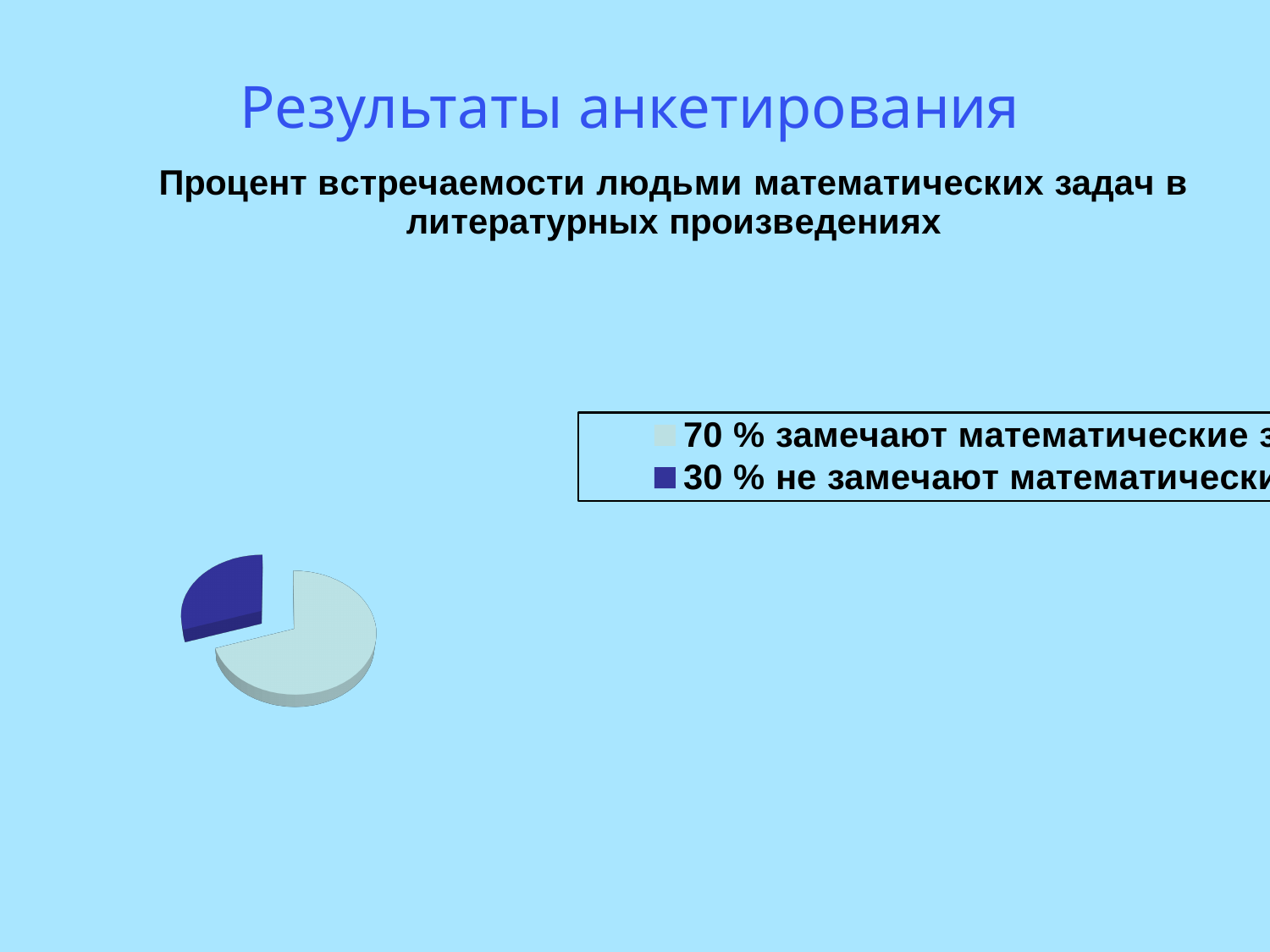
How many entries does the legend of the pie chart list? 2 According to the legend, what percentage of people notice mathematical problems (замечают математические задачи)? 70 % According to the legend, what percentage of people do not notice mathematical problems (не замечают математические задачи)? 30 % What kind of chart is shown on the slide? pie chart What colour is the slice representing the 30 % who do not notice mathematical problems? dark blue What is the title of the chart on the slide? Процент встречаемости людьми математических задач в литературных произведениях What is the difference in percentage points between the share of people who notice mathematical problems and those who do not? 40 Which category has the smallest share of the pie? 30 % не замечают математические задачи Which category has the largest share of the pie? 70 % замечают математические задачи Which slice of the pie is larger: the one for people who notice mathematical problems or the one for people who do not? the one for people who notice (70 %) How many slices does the pie chart have? 2